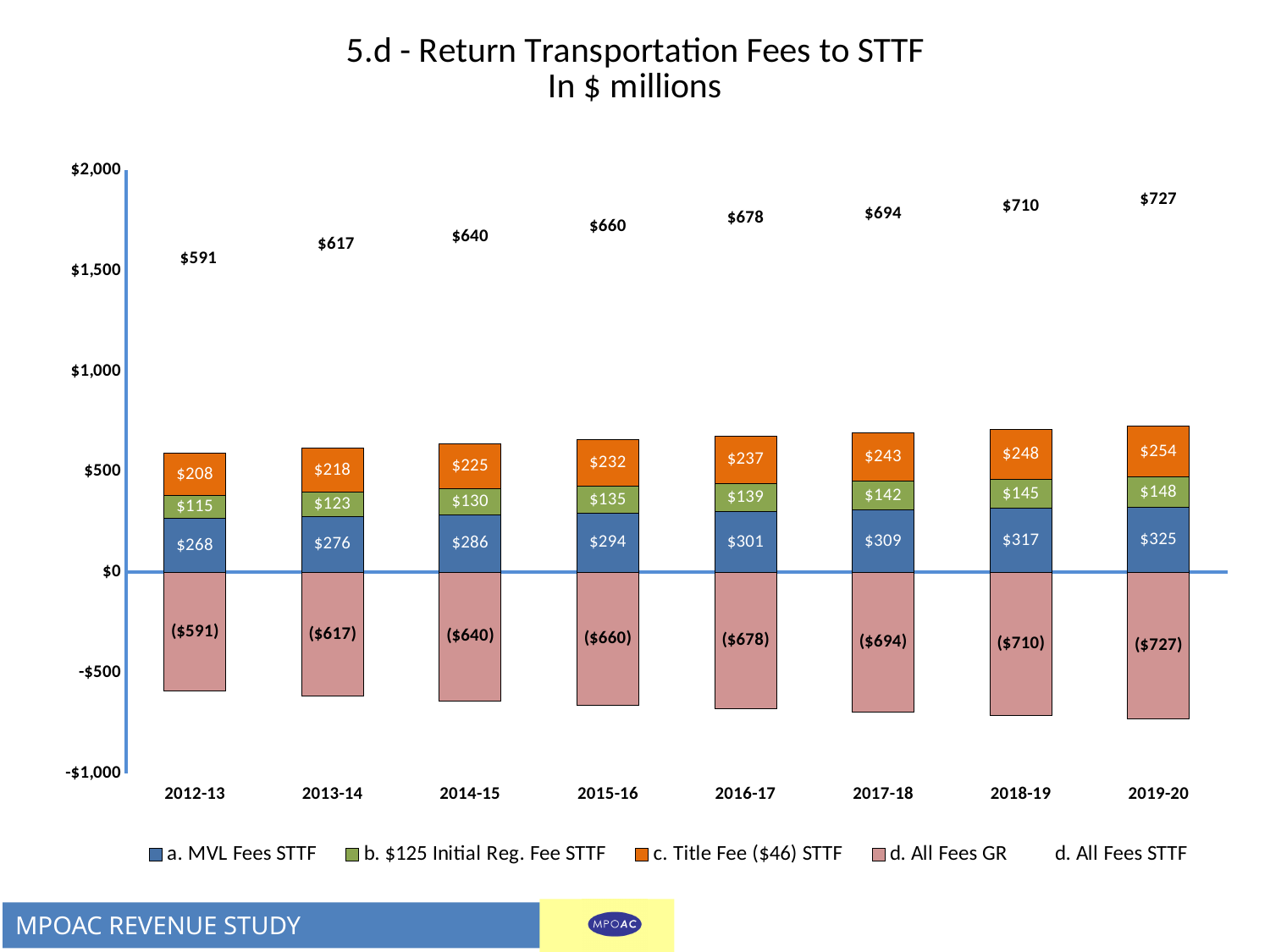
What is the value of b. $125 Initial Reg. Fee STTF for 2012-13? $115 What is the value of c. Title Fee ($46) STTF for 2019-20? $254 Which year has the lowest value for c. Title Fee ($46) STTF? 2012-13 How many years are shown on the x axis? 8 Which year has the highest value for a. MVL Fees STTF? 2019-20 What is the difference between the a. MVL Fees STTF values for 2019-20 and 2012-13? $57 What is the d. All Fees STTF value shown above the bar for 2014-15? $640 What is the value of a. MVL Fees STTF for 2015-16? $294 What is the value of d. All Fees GR for 2017-18? ($694) Which is larger: c. Title Fee ($46) STTF for 2016-17 or b. $125 Initial Reg. Fee STTF for 2016-17? c. Title Fee ($46) STTF for 2016-17 How many series does the legend list? 5 Does the value of a. MVL Fees STTF rise or fall from 2012-13 to 2019-20? rise